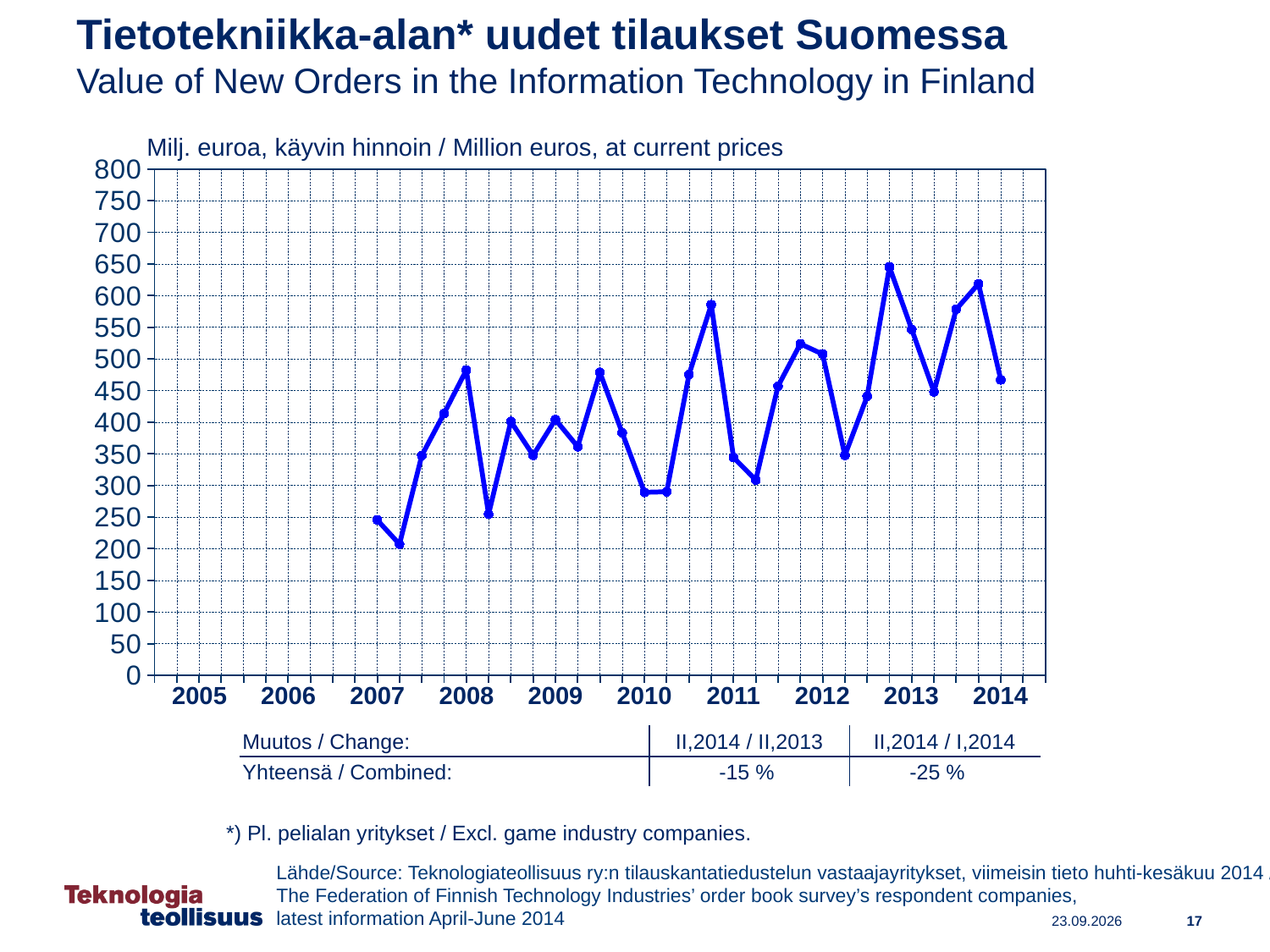
Is the last plotted value, in 2014, greater or less than 500? less Is the highest point on the line greater or less than 600? greater Is the lowest point on the line greater or less than 150? greater What is the combined change for II,2014 compared with I,2014 shown in the table below the chart? -25 % Overall, do the values rise or fall from 2007 to 2014? rise What unit is the y axis measured in, according to the label above the chart? Million euros, at current prices What is the combined change for II,2014 compared with II,2013 shown in the table below the chart? -15 % What kind of chart is shown on the slide? line chart What is the title of the chart in English? Value of New Orders in the Information Technology in Finland